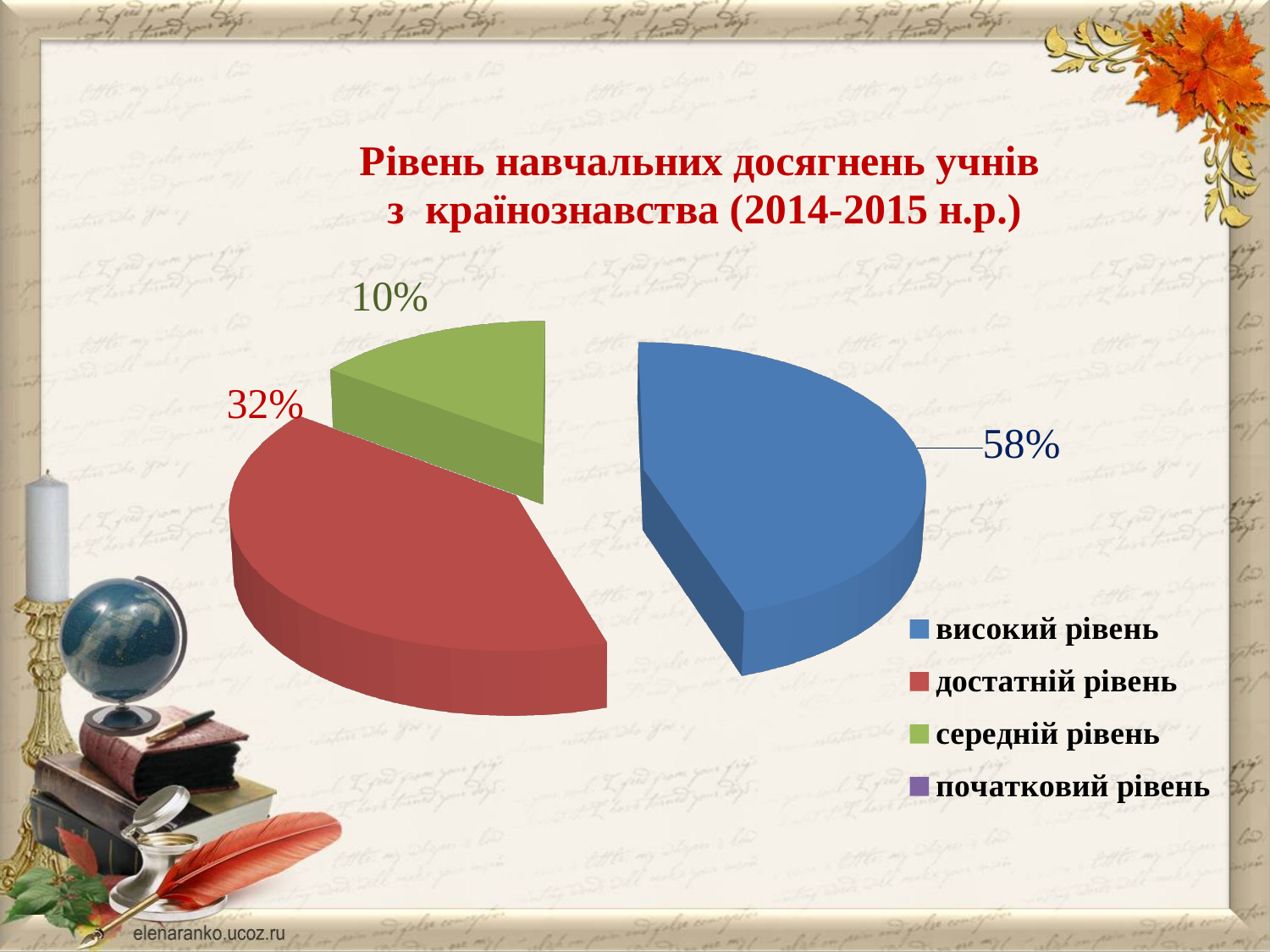
Which level has the largest slice of the pie? високий рівень What colour is the slice for високий рівень? blue Of the slices that carry a percentage label, which level has the smallest slice? середній рівень Which school year does the chart title refer to? 2014-2015 н.р. Which is larger: the slice for достатній рівень or the slice for середній рівень? достатній рівень What percentage of the pie is labelled for достатній рівень? 32% What percentage of the pie is labelled for високий рівень? 58% How many entries does the legend list? 4 What percentage of the pie is labelled for середній рівень? 10% How many slices with percentage labels are visible in the pie? 3 What kind of chart is shown on the slide? pie chart By how many percentage points does високий рівень exceed достатній рівень? 26 percentage points